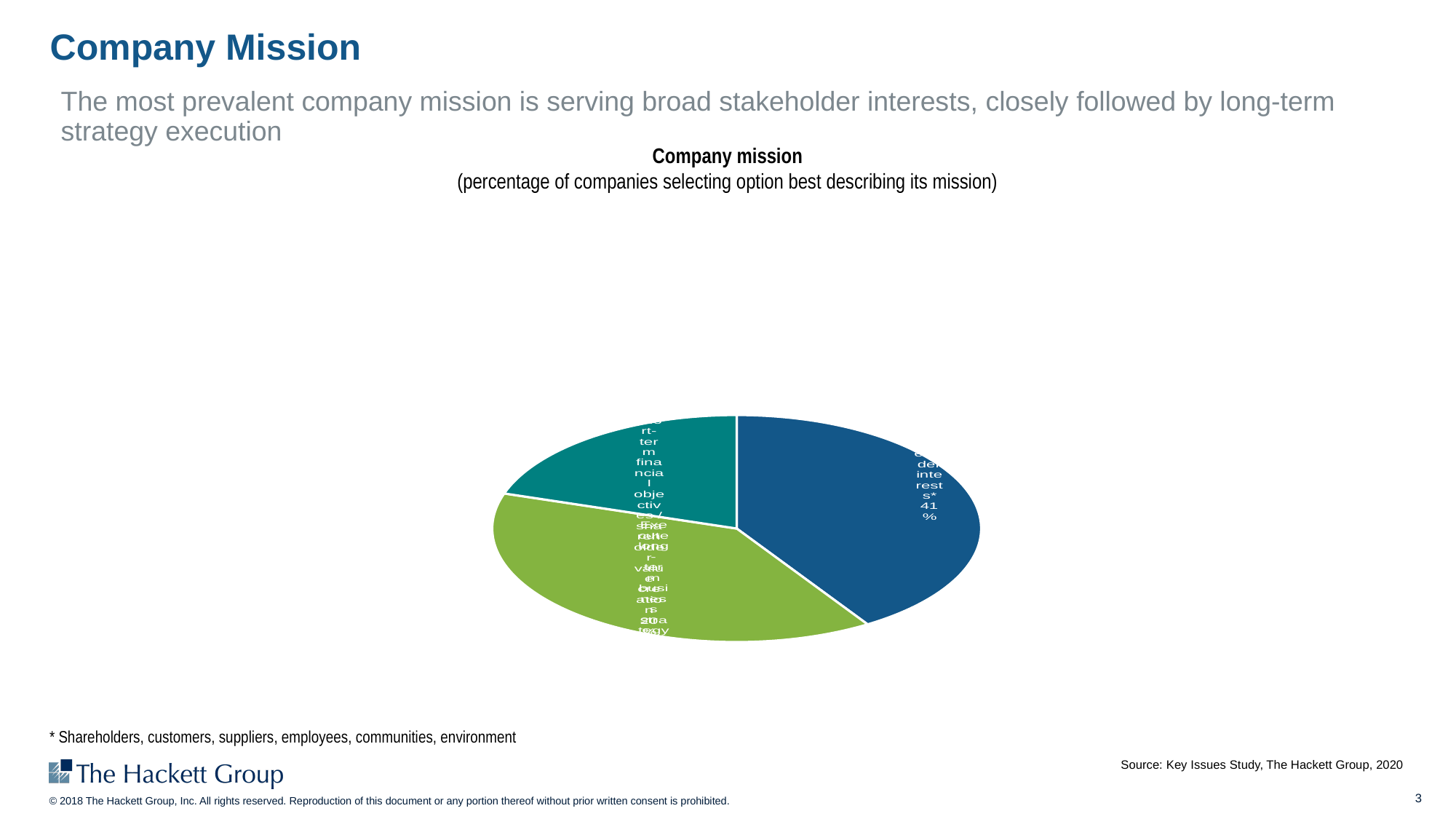
Which slice of the pie chart is the largest? Stakeholder interests (41%) Is the dark blue slice larger or smaller than the green slice? larger Is the green slice larger or smaller than the teal slice? larger Which colour slice of the pie chart is the smallest? the teal slice What is the title of the chart? Company mission What kind of chart is shown on the slide? pie chart What does the chart's subtitle say it measures? percentage of companies selecting option best describing its mission How many slices does the pie chart have? 3 What percentage of companies selected serving broad stakeholder interests as their mission? 41%